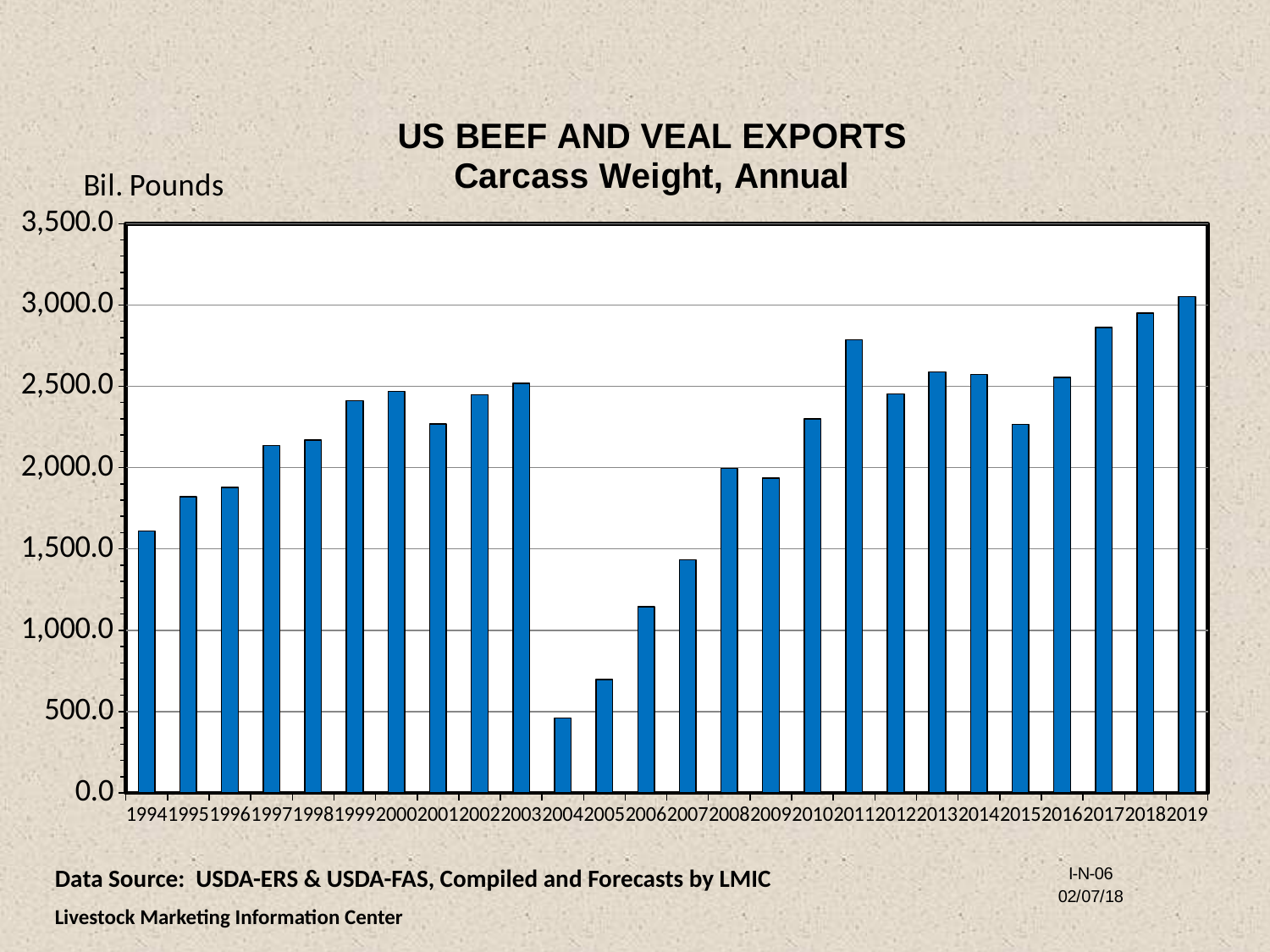
Is the value for 2015 greater or less than 2,500.0? less Which is larger, the value for 2003 or the value for 2004? 2003 Which year has the highest value? 2019 Is the value for 2004 greater or less than 1,000.0? less Do the values rise or fall from 2004 to 2011? rise What kind of chart is shown on the slide? bar chart Which is larger, the value for 2011 or the value for 2012? 2011 Is the value for 2011 greater or less than 2,500.0? greater What unit is shown on the y axis label? Bil. Pounds Which year has the lowest value? 2004 How many years are plotted on the x axis? 26